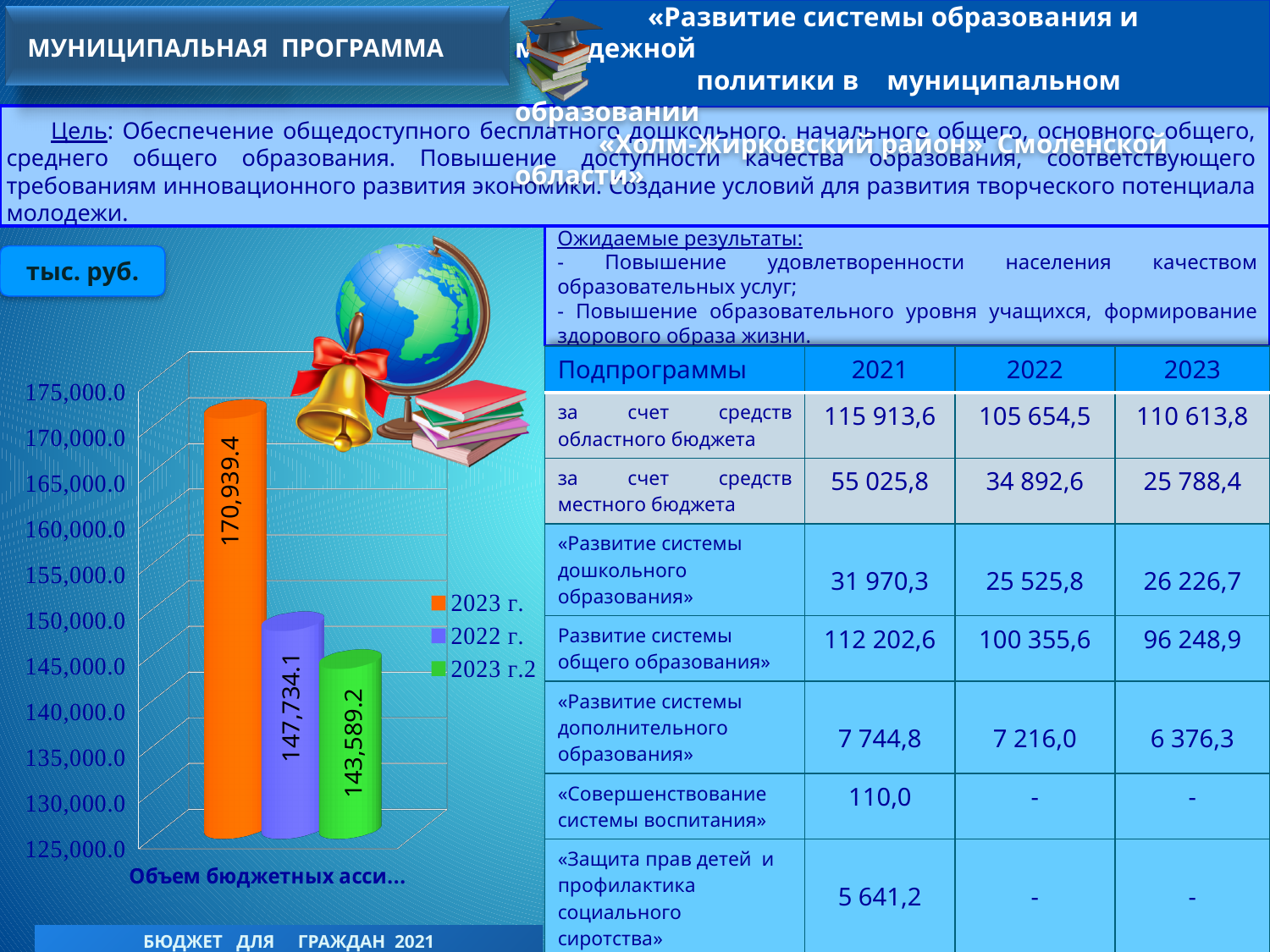
Which legend entry has the highest bar in the chart? 2023 г. Which is larger, the bar for "2022 г." or the bar for "2023 г.2"? 2022 г. Which legend entry has the lowest bar in the chart? 2023 г.2 What is the difference between the bars for "2022 г." and "2023 г.2"? 4,144.9 Is the value for "2022 г." greater or less than 150,000.0? less What is the value of the bar for the legend entry "2023 г."? 170,939.4 What unit is indicated for the chart values in the label at the top left of the chart? тыс. руб. What is the value of the bar for the legend entry "2022 г."? 147,734.1 What is the value of the bar for the legend entry "2023 г.2"? 143,589.2 How many series does the chart legend list? 3 What is the difference between the bars for "2023 г." and "2022 г."? 23,205.3 What type of chart is shown on the slide? bar chart